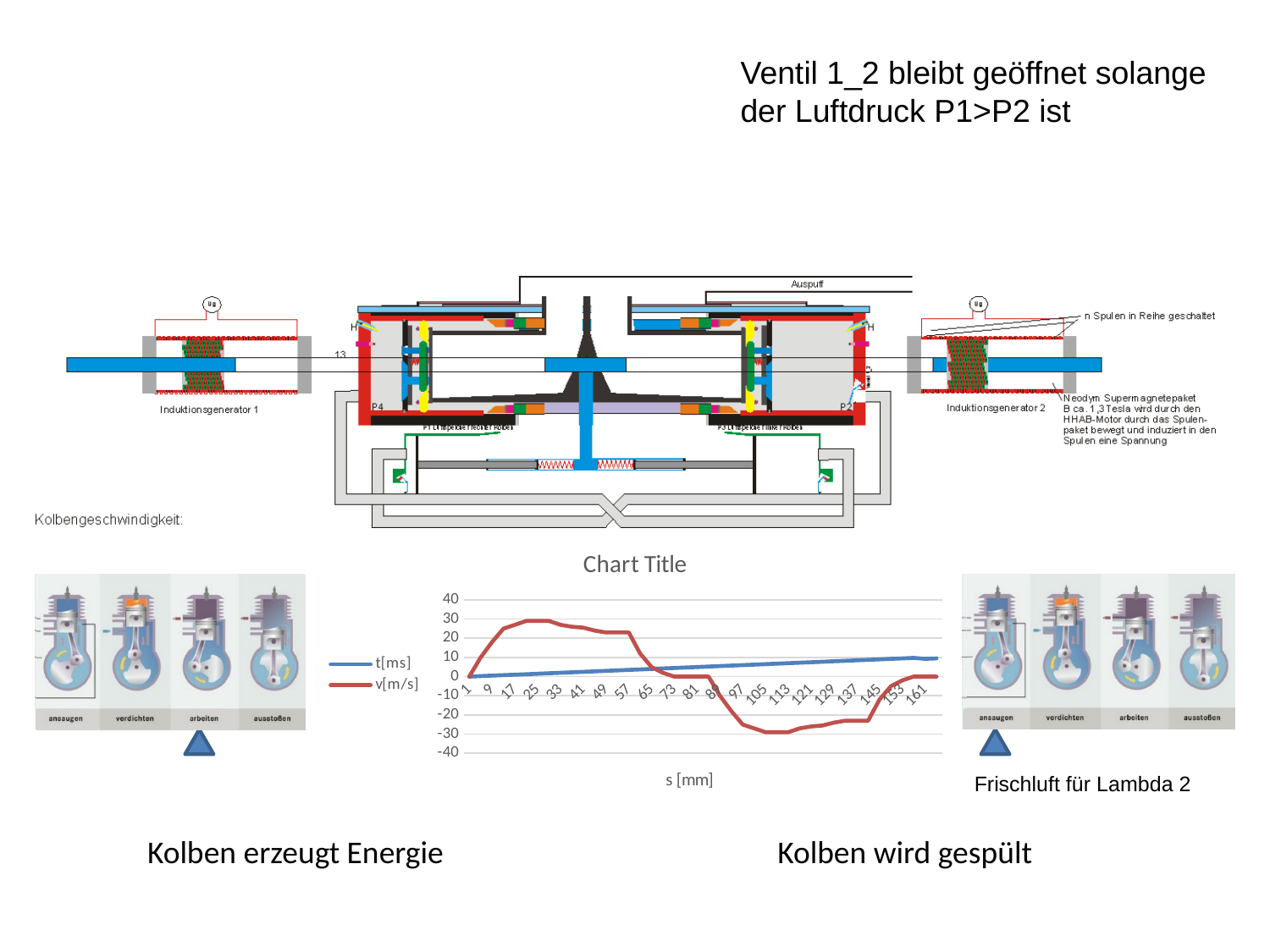
Is the value of v[m/s] at s = 57 greater or less than 10? greater How many series does the chart's legend list? 2 Is the value of v[m/s] at s = 105 greater or less than -20? less At s = 161, which series has the larger value, t[ms] or v[m/s]? t[ms] What kind of chart is shown on the slide? line chart What is the lowest value shown on the chart's y axis? -40 Does the t[ms] series rise or fall as s increases along the x axis? rises Is the value of v[m/s] at s = 25 greater or less than 20? greater Which is larger: the value of v[m/s] at s = 25 or at s = 105? at s = 25 What is the title of the chart's x axis? s [mm] What are the two series named in the chart's legend? t[ms] and v[m/s]